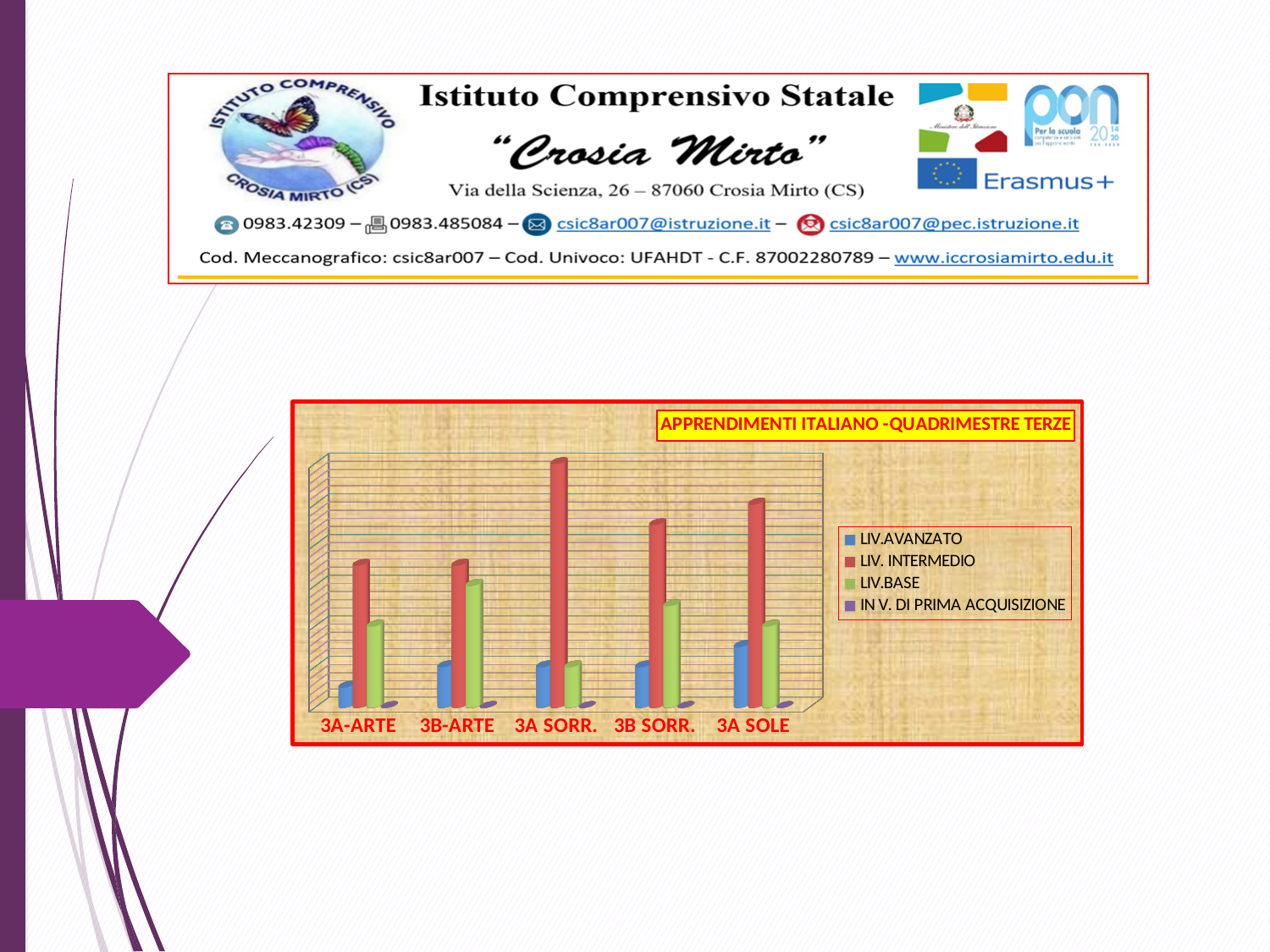
What is the title of the chart? APPRENDIMENTI ITALIANO -QUADRIMESTRE TERZE Which class has the lowest LIV.AVANZATO bar? 3A-ARTE Which series is shown in red? LIV. INTERMEDIO For 3B SORR., which is larger: LIV. INTERMEDIO or LIV.BASE? LIV. INTERMEDIO What kind of chart is shown on the slide? Bar chart Which class has the highest LIV.AVANZATO bar? 3A SOLE Is the LIV. INTERMEDIO bar larger for 3A SORR. or for 3A SOLE? 3A SORR. How many series does the legend list? 4 Which class has the highest LIV. INTERMEDIO bar? 3A SORR. Which class has the lowest LIV.BASE bar? 3A SORR. Which class has the highest LIV.BASE bar? 3B-ARTE How many classes (categories) are shown on the x axis? 5